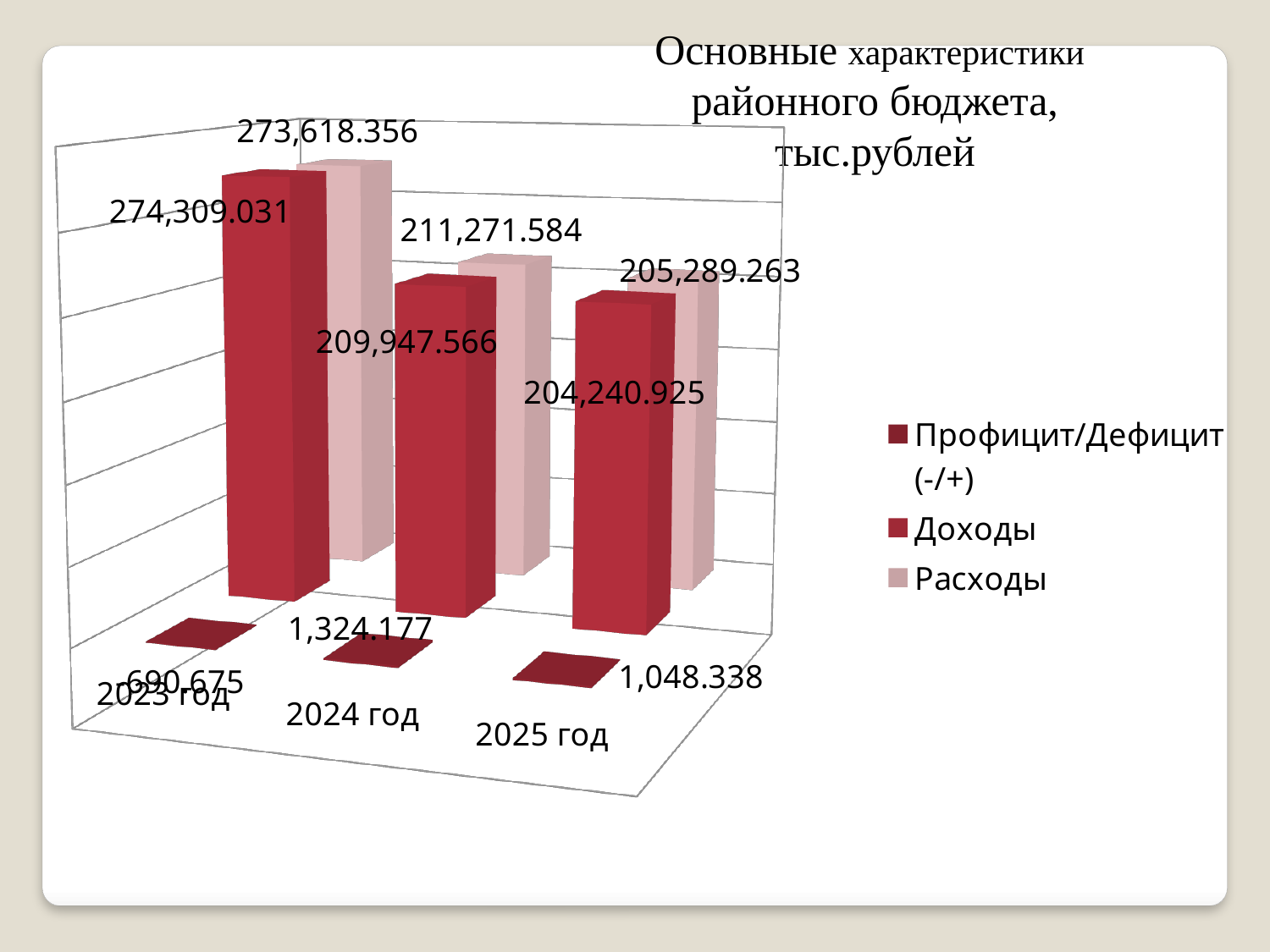
Which is larger for 2023 год: Доходы or Расходы? Доходы Do the Доходы values rise or fall from 2023 год to 2025 год? fall How many series does the legend list? 3 What is the difference between Расходы and Доходы for 2025 год? 1,048.338 What is the value of Расходы for 2024 год? 211,271.584 What type of chart is shown on the slide? bar chart Which year has the highest value of Доходы? 2023 год What is the value of Доходы for 2023 год? 274,309.031 Which year has the lowest value of Расходы? 2025 год What is the value of Доходы for 2025 год? 204,240.925 What is the value of Профицит/Дефицит (-/+) for 2024 год? 1,324.177 What is the value of Расходы for 2025 год? 205,289.263